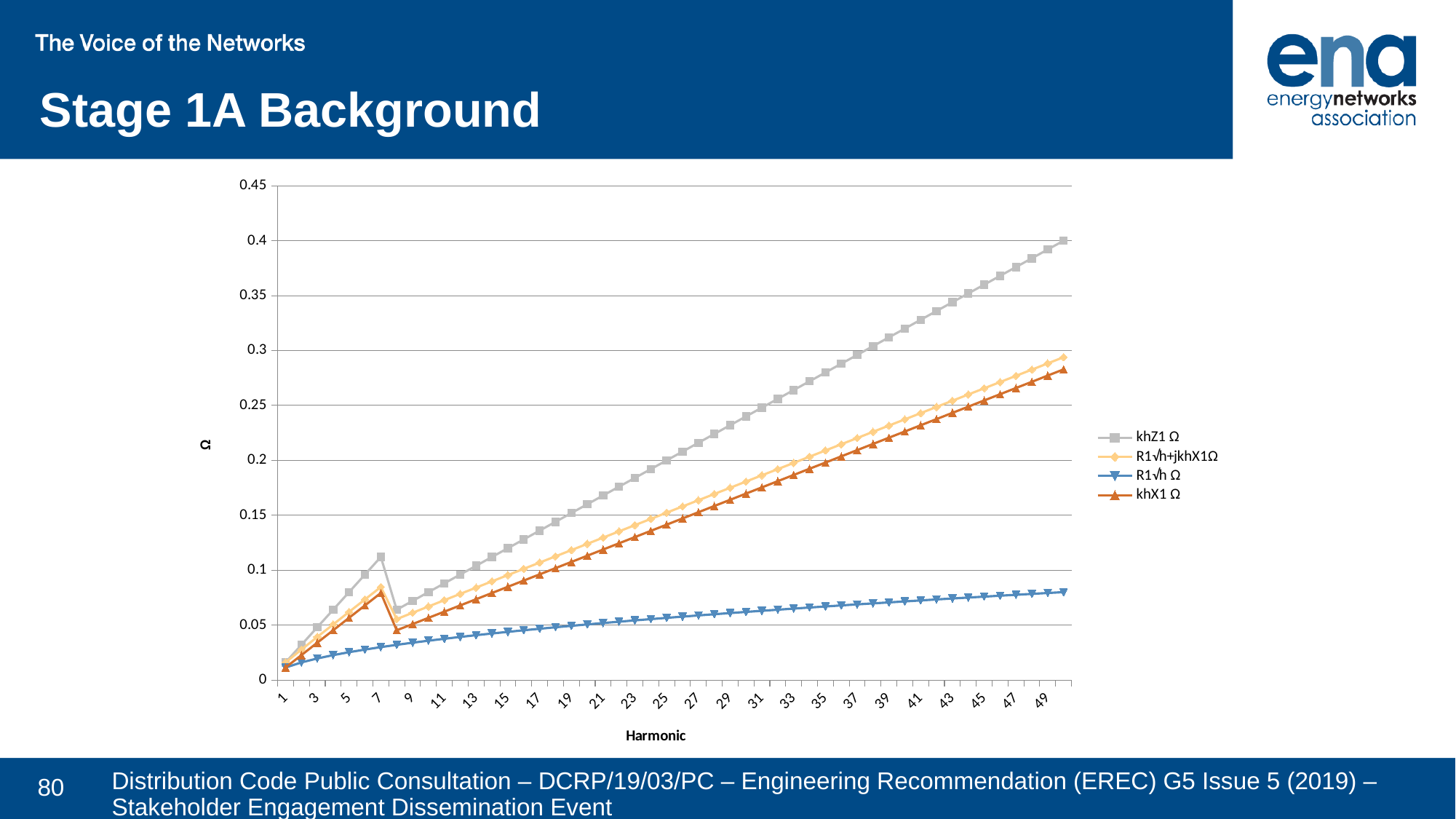
What kind of chart is shown on the slide? Line chart Does the R1√h Ω series rise or fall as the harmonic increases? rise Which series has the highest value at harmonic 49? khZ1 Ω At which harmonic does the khZ1 Ω series show a sharp local peak before dropping? 7 Is the value for khZ1 Ω at harmonic 49 greater or less than 0.35? greater What is the title of the x axis? Harmonic At harmonic 25, which is larger: khZ1 Ω or R1√h Ω? khZ1 Ω Is the value for R1√h+jkhX1Ω at harmonic 25 greater or less than 0.2? less Is the value for khX1 Ω at harmonic 49 greater or less than 0.25? greater How many series does the legend list? 4 Which series has the lowest value at harmonic 49? R1√h Ω